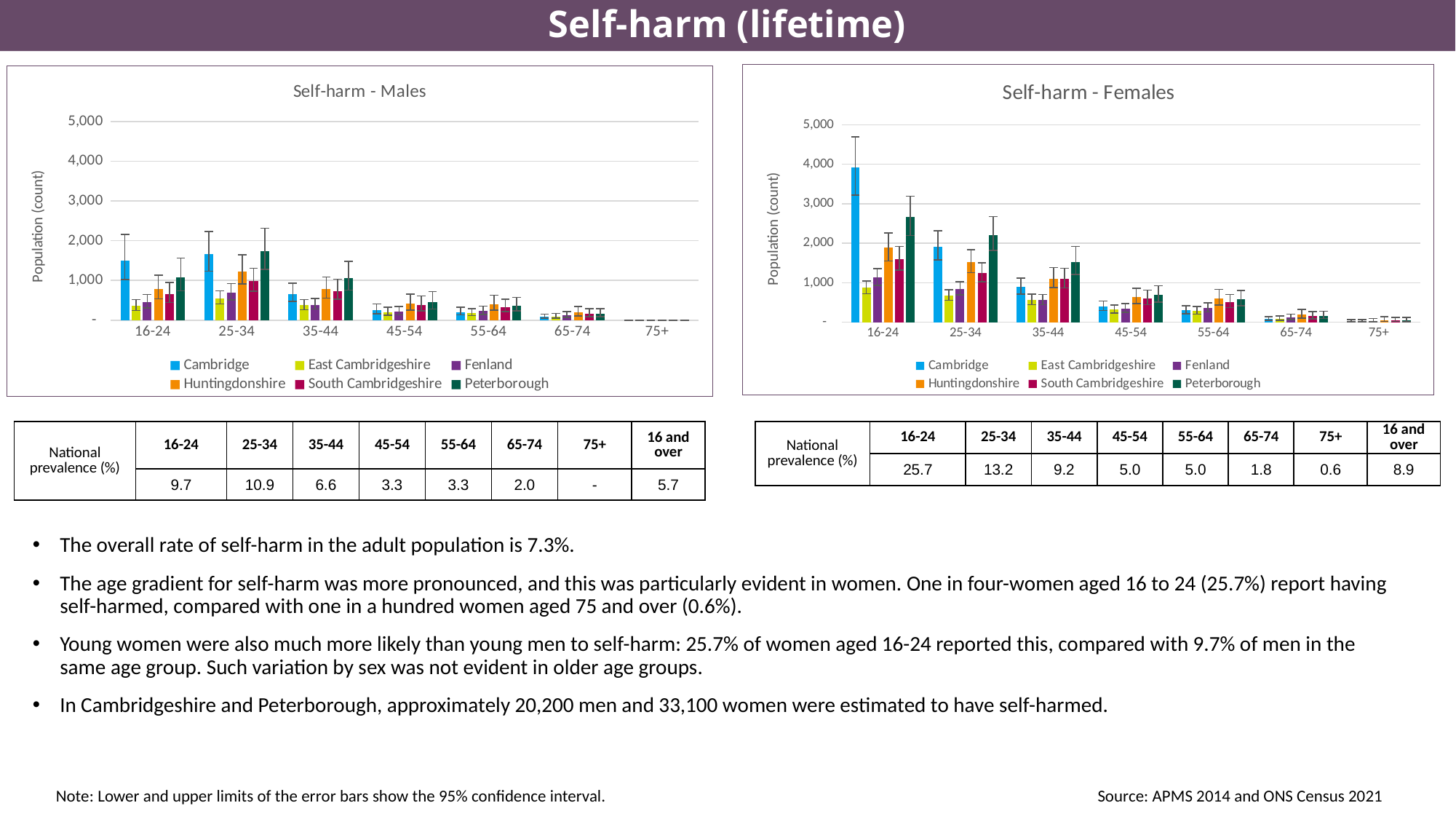
In the 'Self-harm - Females' chart, which area has the tallest bar in the 16-24 age group? Cambridge In the 'Self-harm - Males' chart, is the value for Peterborough in the 25-34 age group greater or less than 1,000? greater What kind of chart is the 'Self-harm - Males' chart? bar chart In the 'Self-harm - Males' chart, which age group has the tallest Peterborough bar? 25-34 In the 'Self-harm - Males' chart, is the value for Cambridge in the 16-24 age group greater or less than 1,000? greater How many age groups are shown on the x axis of the 'Self-harm - Females' chart? 7 In the 'Self-harm - Females' chart, do the Cambridge values rise or fall from the 25-34 age group to the 75+ age group? fall In the 'Self-harm - Females' chart, is the value for Cambridge in the 16-24 age group greater or less than 3,000? greater How many series does the legend of the 'Self-harm - Males' chart list? 6 What is the y-axis label on the 'Self-harm - Males' chart? Population (count) In the 'Self-harm - Females' chart, which is larger in the 16-24 age group: Cambridge or Peterborough? Cambridge